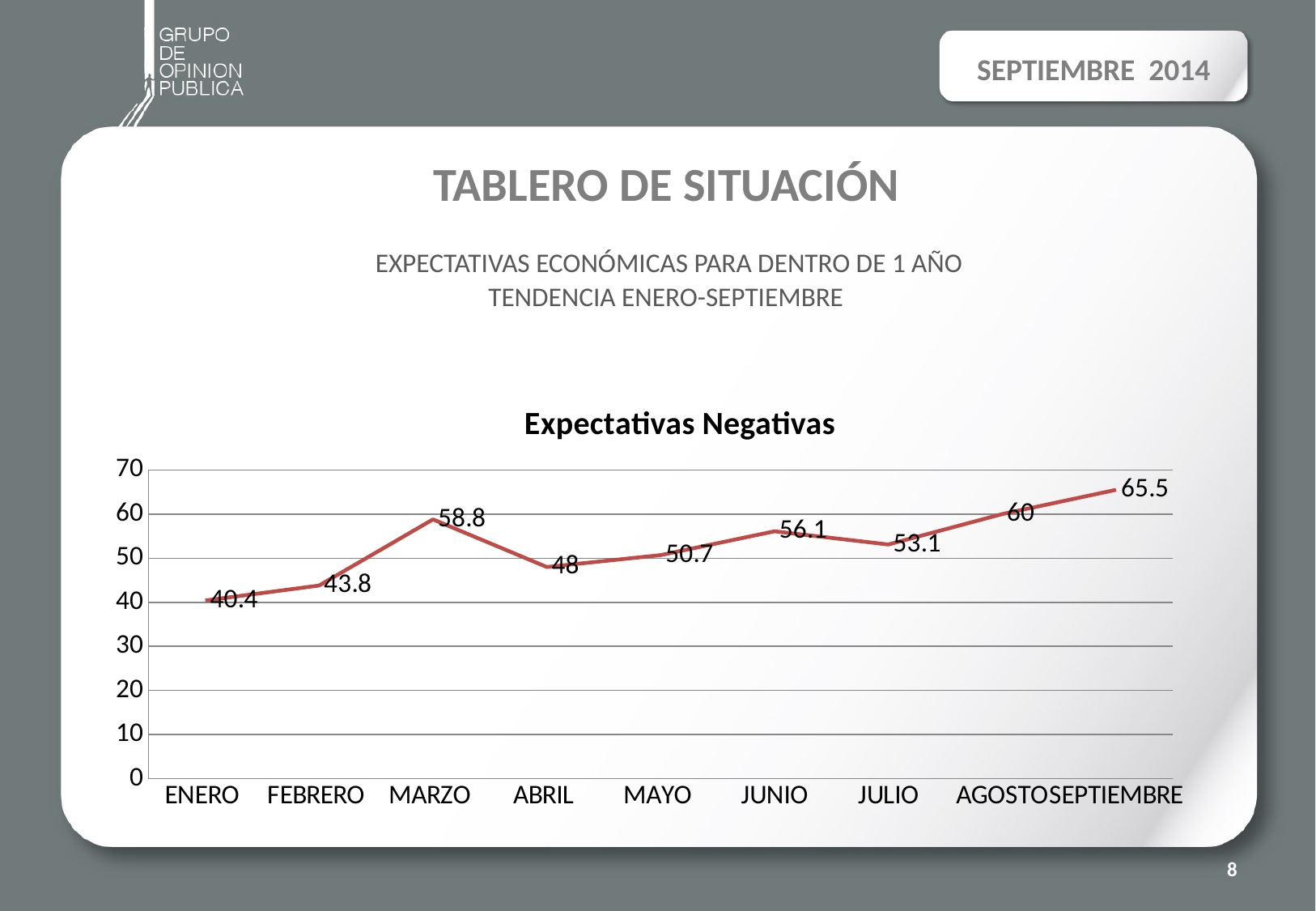
What is the value for ENERO? 40.4 What is the title of the chart? Expectativas Negativas What is the value for MARZO? 58.8 Which is larger, the value for JUNIO or the value for JULIO? JUNIO What is the difference between the values for MARZO and ABRIL? 10.8 What kind of chart is shown? line chart What is the difference between the values for SEPTIEMBRE and ENERO? 25.1 How many months are plotted on the chart? 9 What is the value for SEPTIEMBRE? 65.5 Which month has the lowest value? ENERO Which month has the highest value? SEPTIEMBRE Is the value for AGOSTO greater or less than 50? greater